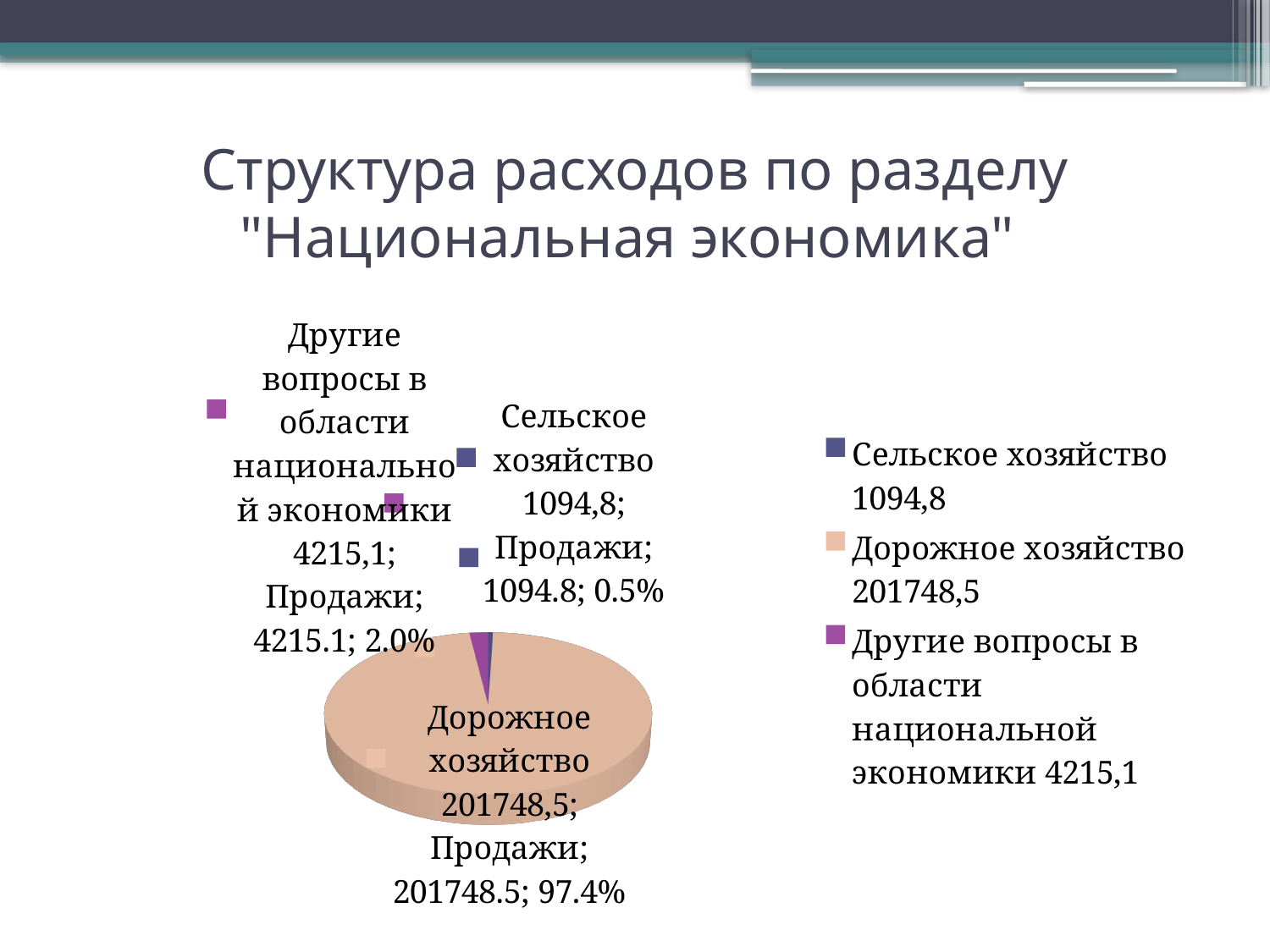
Which is larger, Другие вопросы в области национальной экономики or Сельское хозяйство? Другие вопросы в области национальной экономики What type of chart is shown on the slide? pie chart What is the difference between the values for Другие вопросы в области национальной экономики and Сельское хозяйство? 3120.3 Which category has the smallest slice? Сельское хозяйство What is the value for Другие вопросы в области национальной экономики? 4215.1 What share of the pie does Сельское хозяйство represent? 0.5% What is the value for Дорожное хозяйство? 201748.5 What is the value for Сельское хозяйство? 1094.8 How many entries does the legend list? 3 Which category has the largest slice? Дорожное хозяйство How many slices does the pie chart have? 3 What share of the pie does Дорожное хозяйство represent? 97.4%